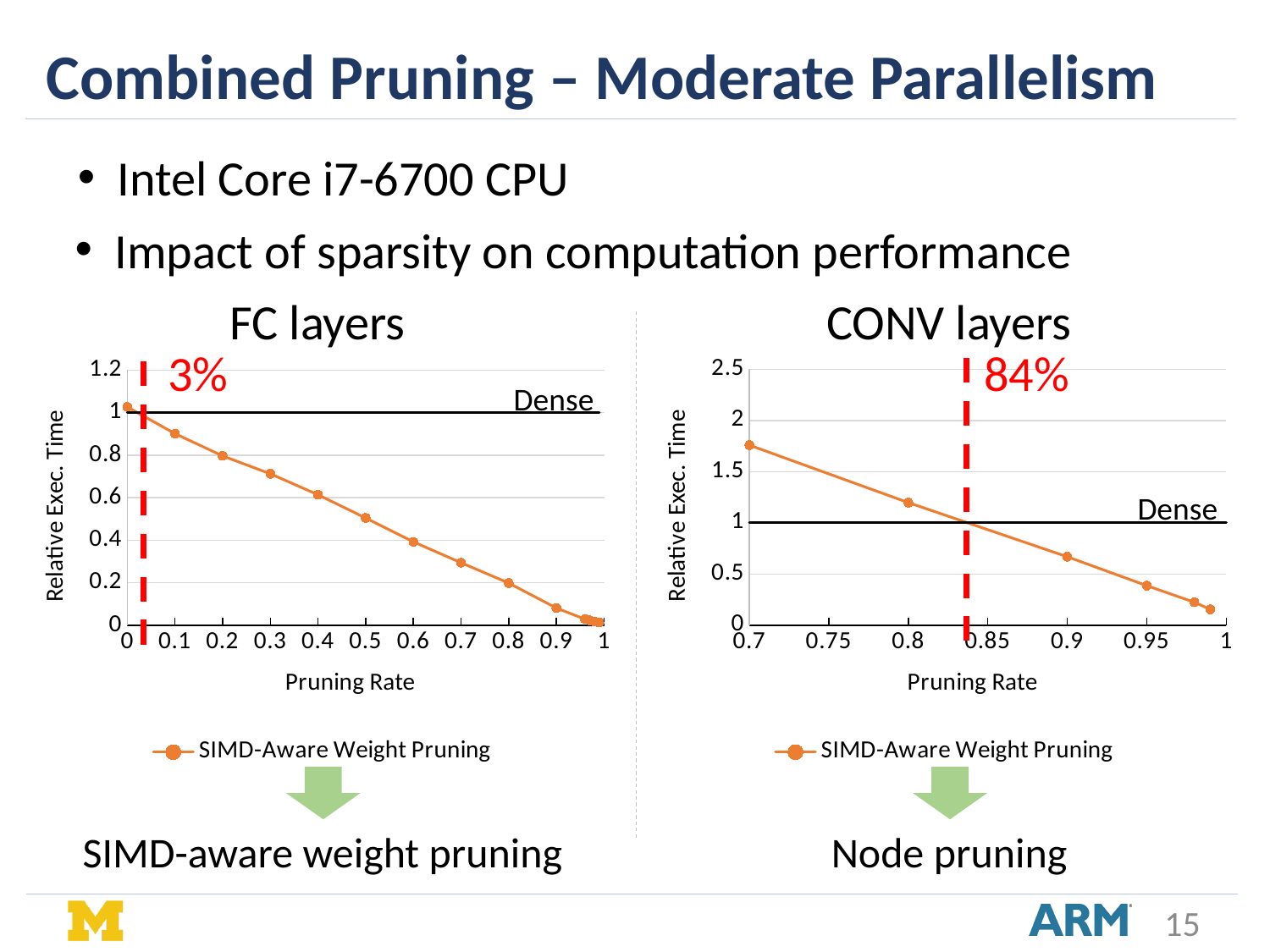
In the FC layers chart, is the relative execution time at pruning rate 0.9 greater or less than 0.2? less What is the name of the series in the legend of the CONV layers chart? SIMD-Aware Weight Pruning In the FC layers chart, which has the larger relative execution time: pruning rate 0.2 or pruning rate 0.6? pruning rate 0.2 In the CONV layers chart, does relative execution time rise or fall as the pruning rate increases? fall What is the x-axis label of the FC layers chart? Pruning Rate In the FC layers chart, is the relative execution time at pruning rate 0.1 greater or less than 0.8? greater In the CONV layers chart, is the relative execution time at pruning rate 0.7 greater or less than 1.5? greater How many series does the legend of the FC layers chart list? 1 What kind of chart is the FC layers chart? line chart In the CONV layers chart, at which pruning rate is the relative execution time highest? 0.7